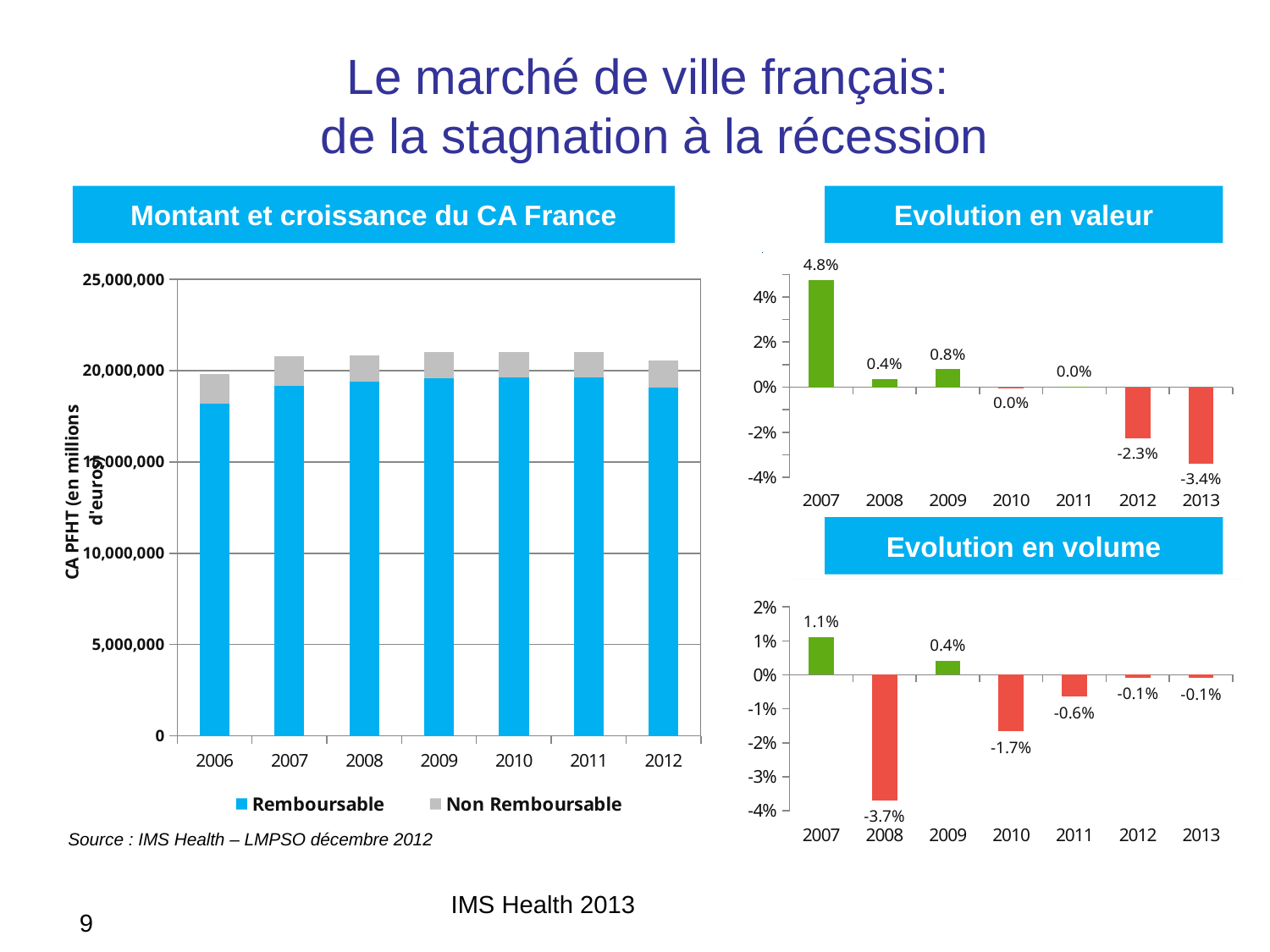
In the 'Evolution en volume' chart, what is the value for 2008? -3.7% What kind of chart is the 'Montant et croissance du CA France' chart? stacked bar chart In the 'Evolution en volume' chart, which year has the highest value? 2007 In the 'Montant et croissance du CA France' chart, how many series does the legend list? 2 In the 'Evolution en volume' chart, how many years are shown on the x axis? 7 In the 'Evolution en volume' chart, which is larger, the value for 2010 or the value for 2011? 2011 In the 'Evolution en valeur' chart, what is the value for 2013? -3.4% In the 'Evolution en valeur' chart, which year has the lowest value? 2013 In the 'Montant et croissance du CA France' chart, is the Remboursable value for 2006 greater or less than 20,000,000? less In the 'Evolution en valeur' chart, what is the difference between the 2007 value and the 2009 value? 4.0% In the 'Evolution en valeur' chart, what is the value for 2007? 4.8% In the 'Evolution en valeur' chart, what colour are the bars with negative values? red